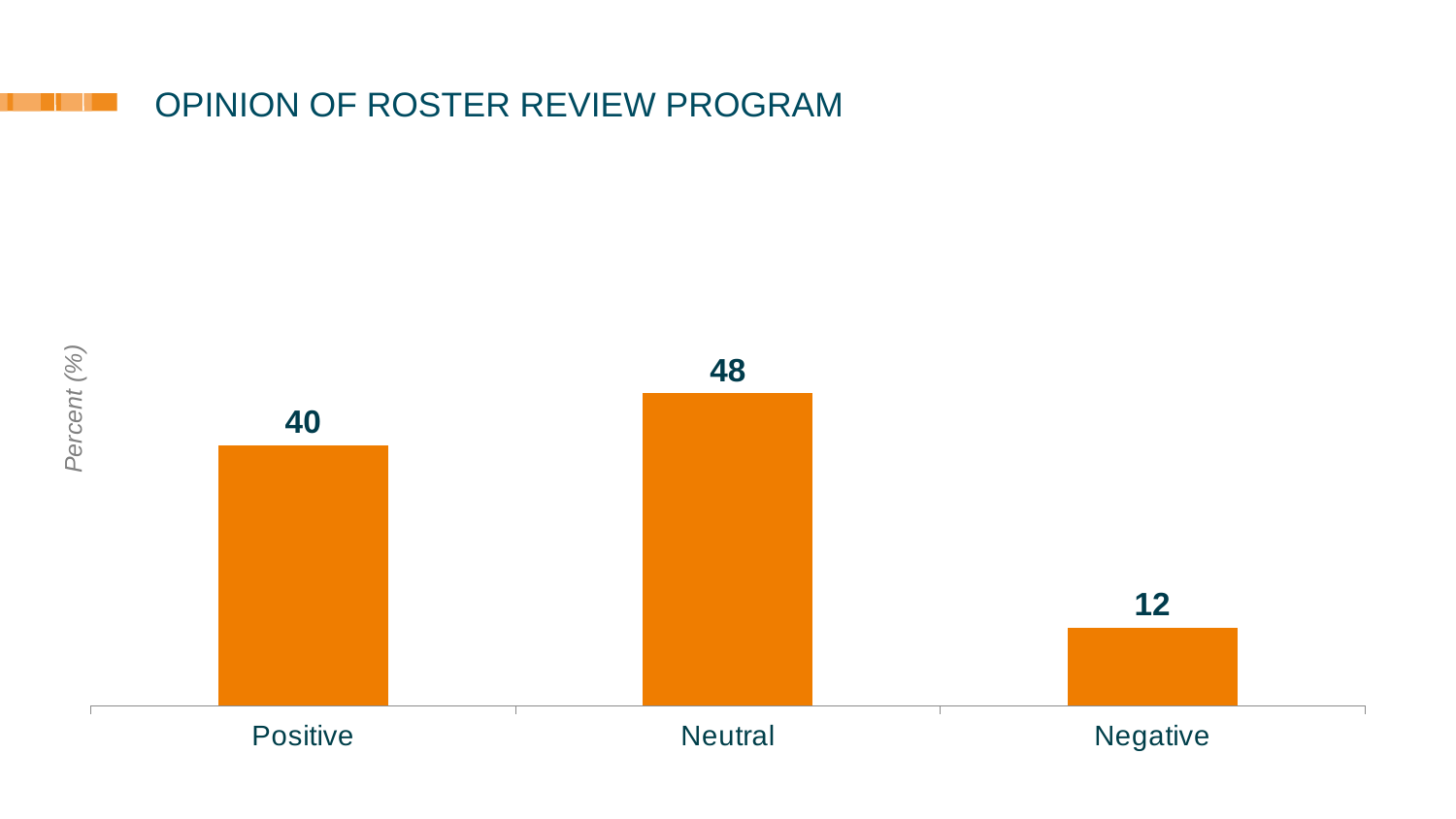
What is the value for Neutral? 48 What is the value for Positive? 40 How many categories are shown in the chart? 3 Which category has the highest value? Neutral What is the difference between the values for Neutral and Positive? 8 Which category has the lowest value? Negative What is the value for Negative? 12 What is the label on the vertical axis? Percent (%) Which is larger, the value for Positive or the value for Negative? Positive What is the title of the slide? OPINION OF ROSTER REVIEW PROGRAM What kind of chart is shown on the slide? Bar chart What is the difference between the values for Positive and Negative? 28